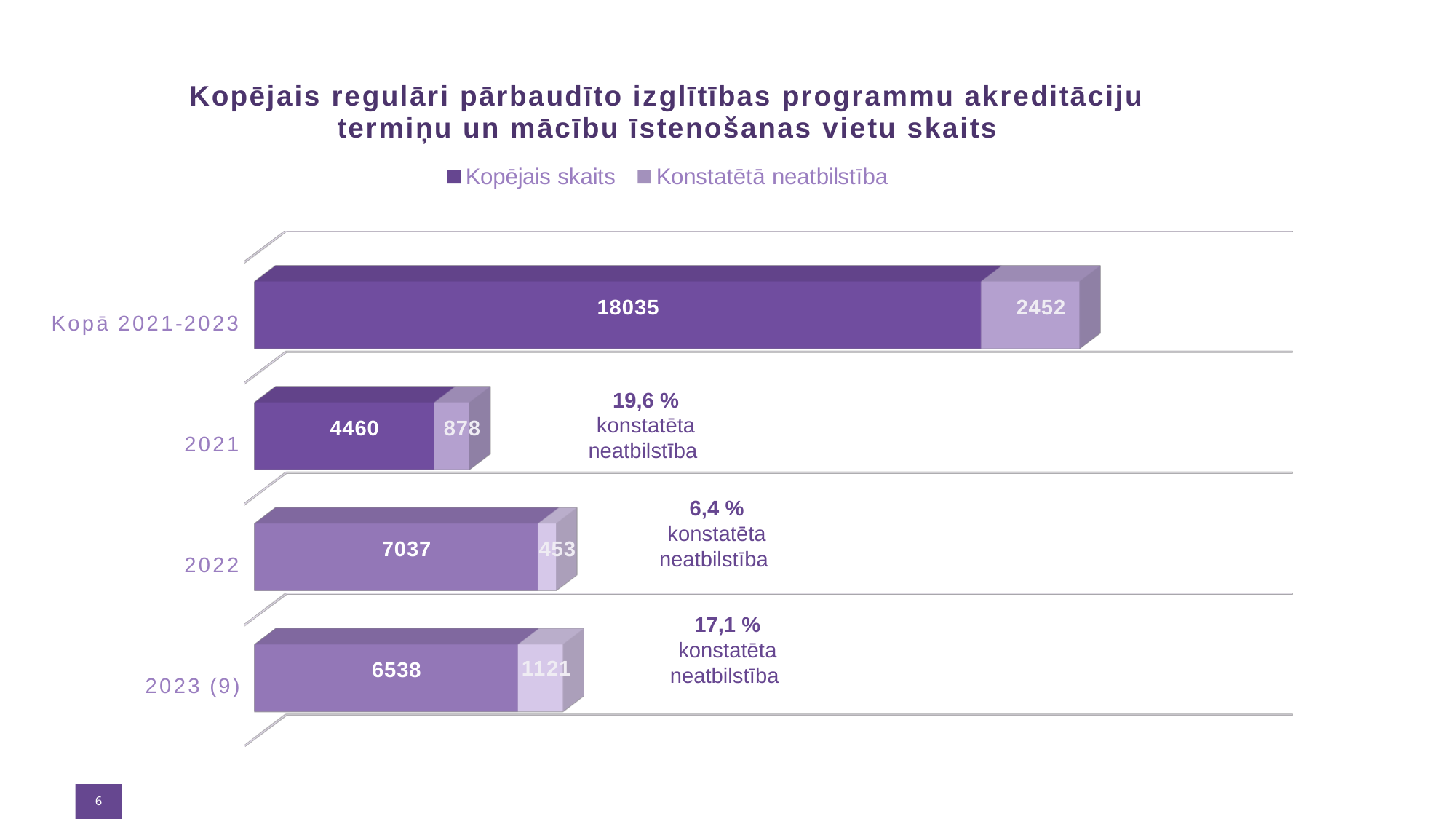
Which is larger: Konstatētā neatbilstība for 2023 (9) or for 2021? 2023 (9) How many series does the legend list? 2 Among the single years 2021, 2022 and 2023 (9), which has the highest Kopējais skaits? 2022 What is the value of Kopējais skaits for 2022? 7037 What is the value of Konstatētā neatbilstība for 2021? 878 What is the difference between Kopējais skaits for 2022 and for 2021? 2577 What is the value of Kopējais skaits for Kopā 2021-2023? 18035 How many categories are shown on the chart? 4 What is the total of the stacked bar for 2021? 5338 What kind of chart is shown on the slide? Stacked bar chart What is the value of Konstatētā neatbilstība for 2023 (9)? 1121 Among the single years 2021, 2022 and 2023 (9), which has the lowest Konstatētā neatbilstība? 2022